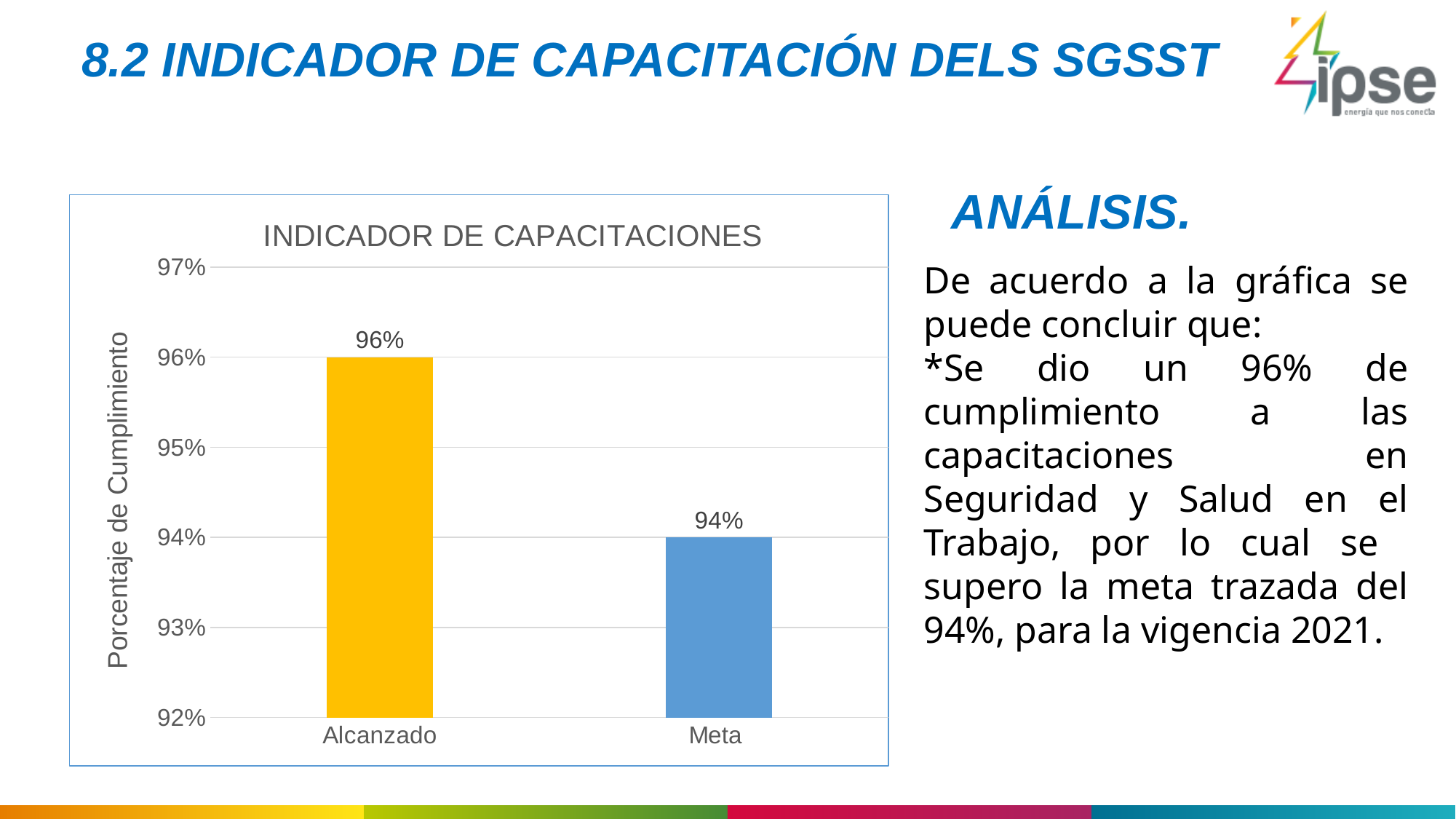
Which category has the highest value? Alcanzado Which is larger, the value for Alcanzado or the value for Meta? Alcanzado What kind of chart is shown? bar chart What is the title of the chart? INDICADOR DE CAPACITACIONES What is the difference between the values for Alcanzado and Meta? 2% Which category has the lowest value? Meta What is the value for Meta? 94% How many categories are shown on the x axis? 2 What is the value for Alcanzado? 96% What is the label of the vertical axis? Porcentaje de Cumplimiento Is the value for Meta greater or less than 95%? less Is the value for Alcanzado greater or less than 95%? greater